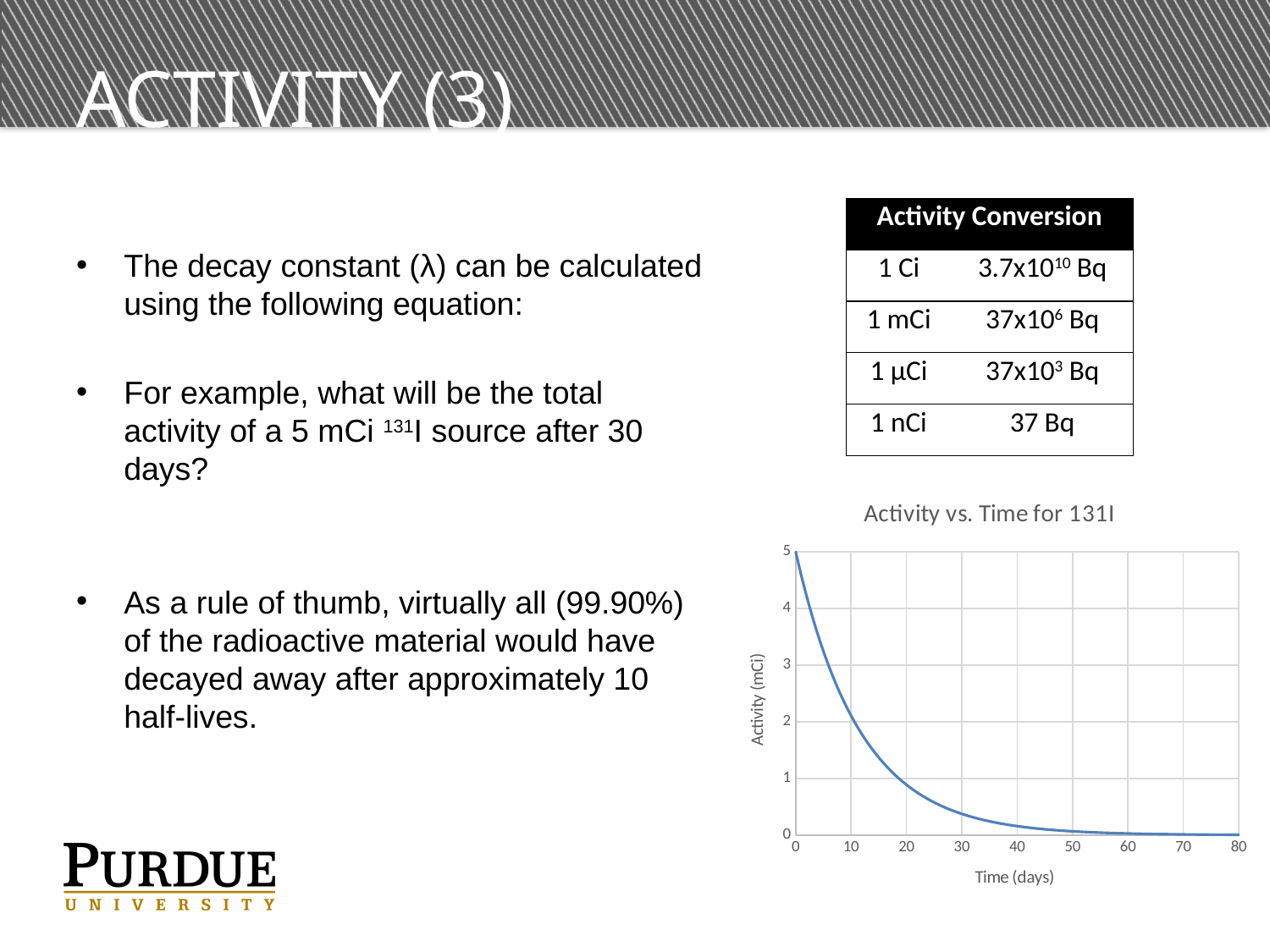
What is the activity in mCi at time 0 days on the chart? 5 Is the activity at 30 days greater or less than 1 mCi? less Does the activity rise or fall as time increases along the x axis? fall What is the label of the y axis of the chart? Activity (mCi) Is the activity at 5 days greater or less than 2 mCi? greater Which is larger, the activity at 10 days or the activity at 30 days? 10 days Is the activity at 10 days greater or less than 1 mCi? greater What is the title of the chart on the slide? Activity vs. Time for 131I What kind of chart is shown on the slide? line chart At what time (days) is the activity highest on the chart? 0